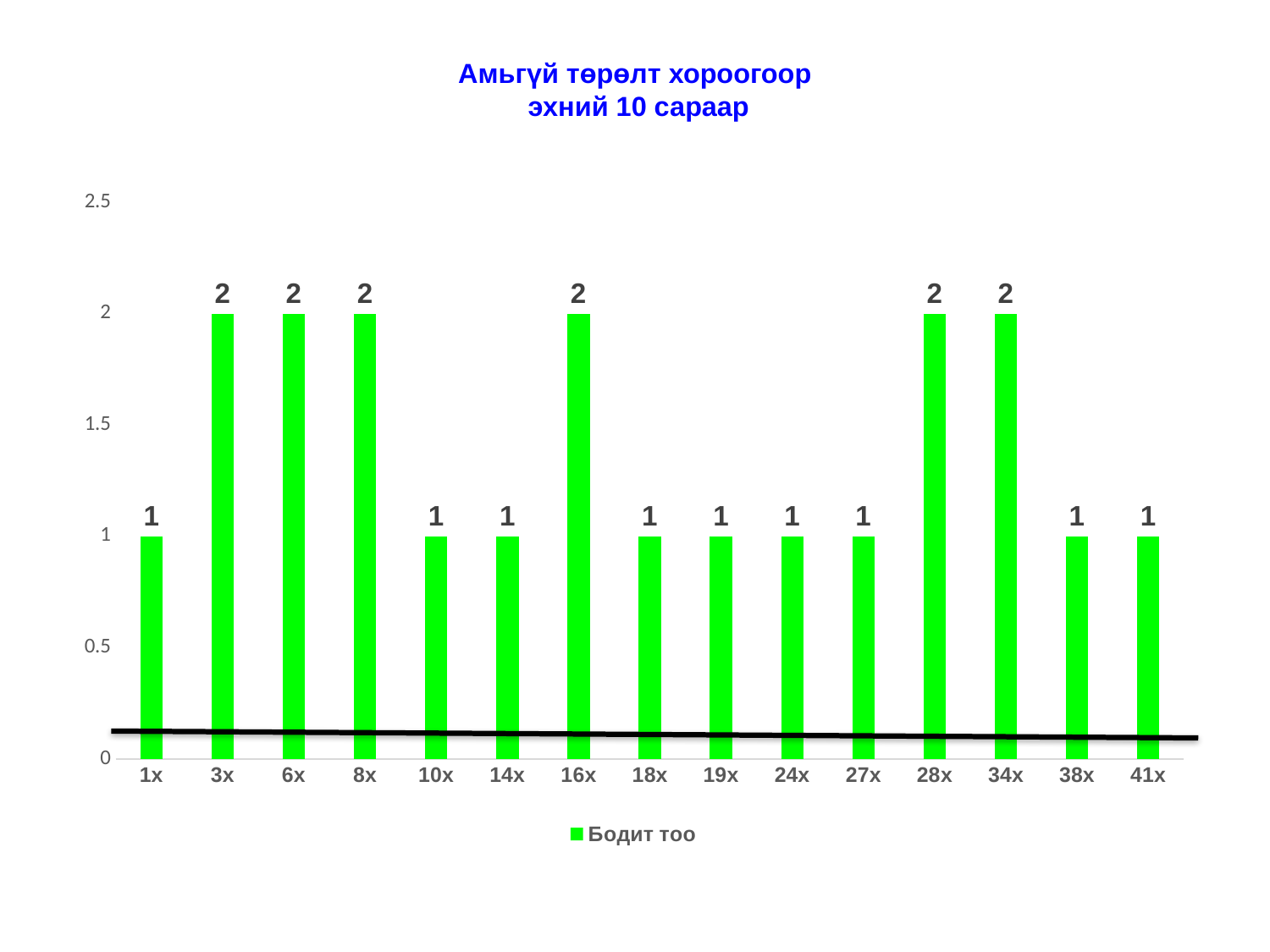
Which has the larger value, 27х or 34х? 34х How many series does the legend list? 1 What is the difference between the values for 16х and 18х? 1 What is the value for 41х? 1 What is the value for 3х? 2 How many categories have a value of 2? 6 What is the value for 10х? 1 What is the legend entry for the green bars? Бодит тоо What is the value for 28х? 2 What kind of chart is shown on the slide? Bar chart Which has the larger value, 8х or 14х? 8х How many categories are shown on the x axis? 15